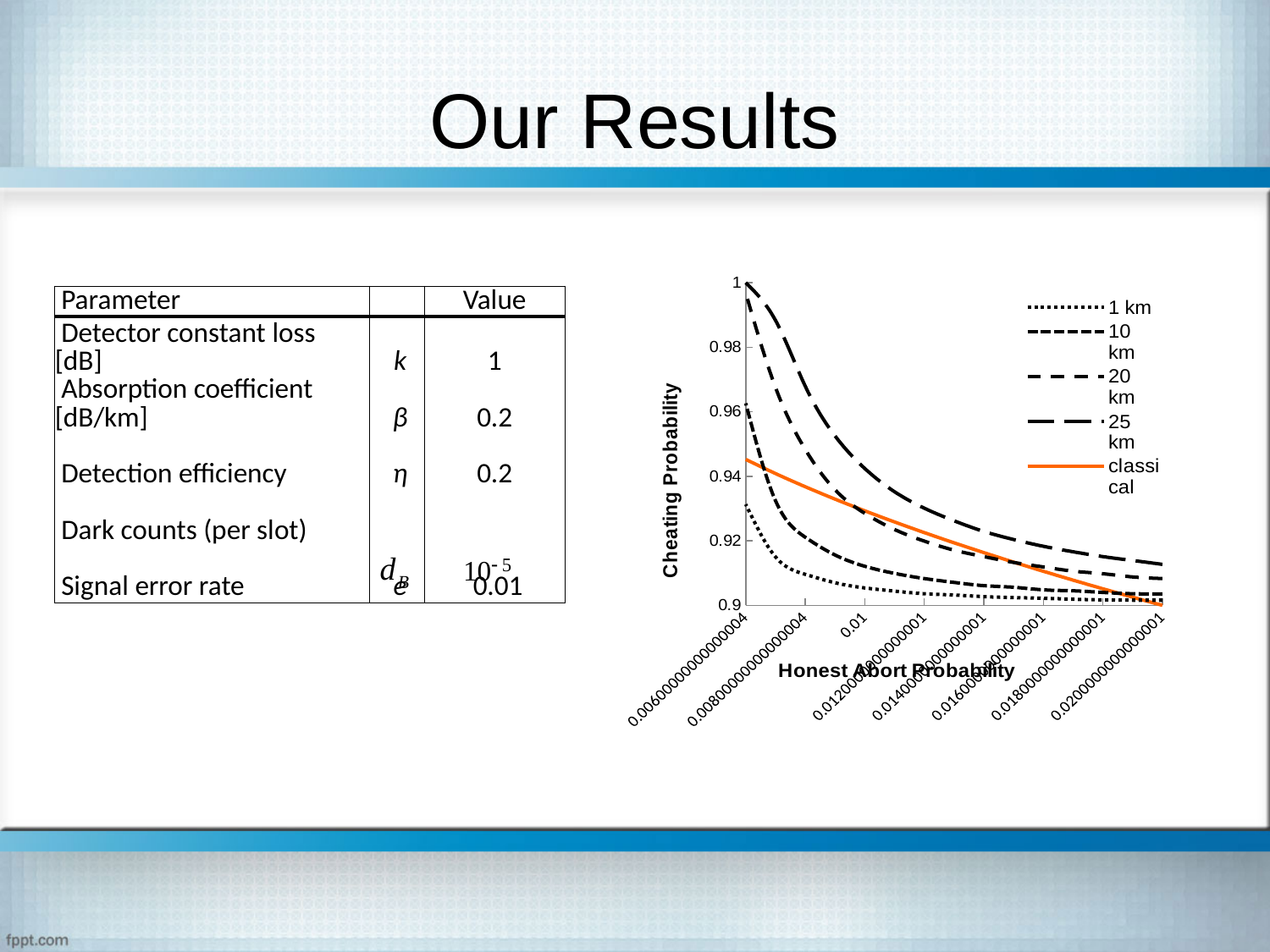
Which series has the lowest cheating probability at the left edge of the chart? 1 km At the left edge of the chart, is the cheating probability for the 25 km series greater or less than 0.98? greater How many series does the chart's legend list? 5 At the left edge of the chart, is the cheating probability for the classical series greater or less than 0.92? greater What is the title of the chart's vertical axis? Cheating Probability Do the cheating probability curves rise or fall as the honest abort probability increases? fall At the right edge of the chart, which series has the higher cheating probability, 25 km or classical? 25 km What is the lowest value shown on the chart's vertical axis? 0.9 What is the title of the chart's horizontal axis? Honest Abort Probability Which series has the highest cheating probability at the left edge of the chart? 25 km At the right edge of the chart, is the cheating probability for the 1 km series greater or less than 0.92? less What kind of chart is shown on the slide? line chart